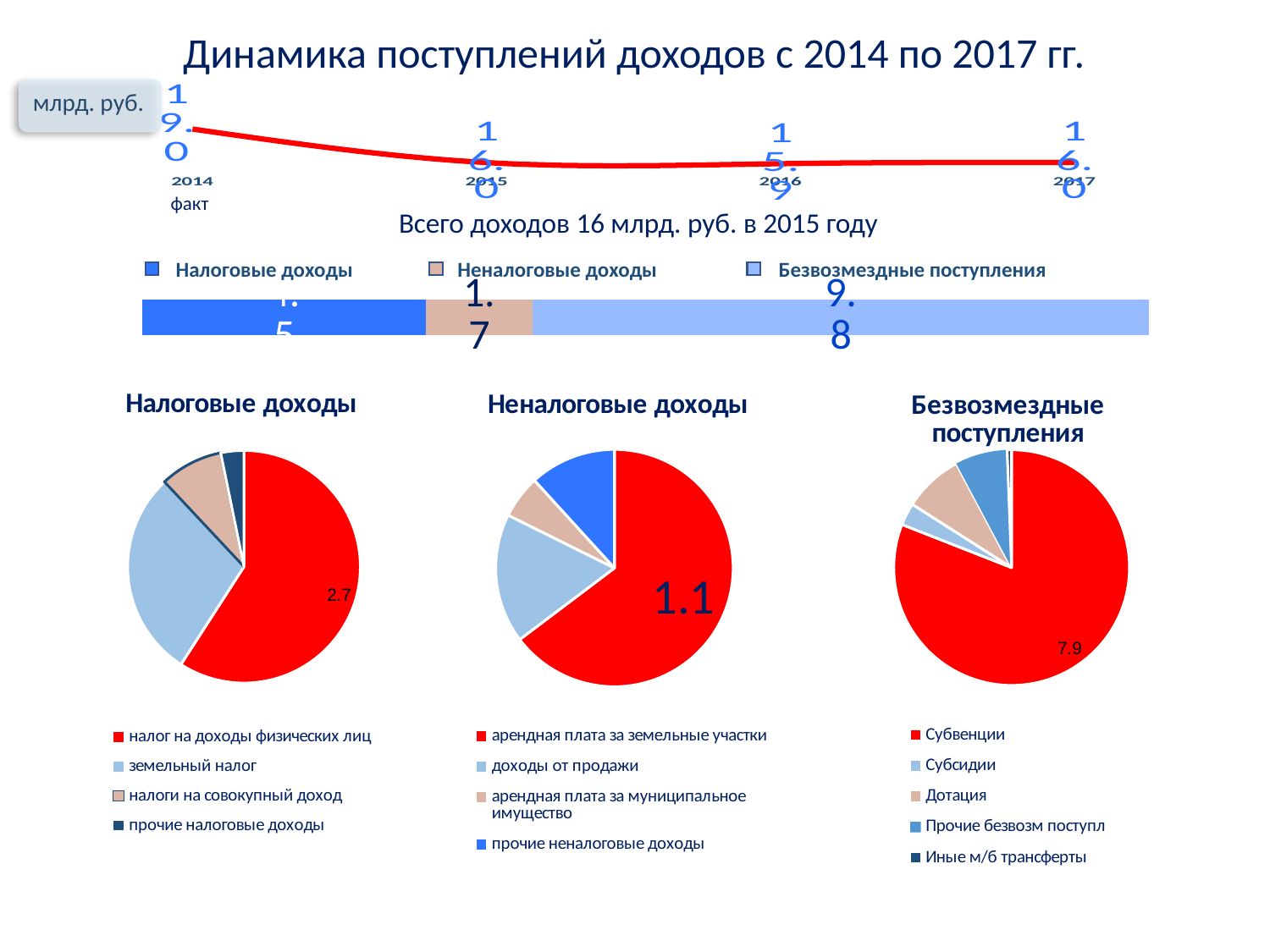
In the stacked bar chart, what is the difference between Безвозмездные поступления and Неналоговые доходы? 8.1 In the stacked bar chart for 2015, what is the value for Безвозмездные поступления? 9.8 In the top line chart, does the value rise or fall from 2014 to 2015? fall In the top line chart, what is the value for 2014? 19.0 What kind of chart is the top chart showing income from 2014 to 2017? line chart In the pie chart titled Безвозмездные поступления, what is the value for Субвенции? 7.9 In the top line chart, what is the value for 2016? 15.9 How many series does the legend of the stacked bar chart list? 3 In the top line chart, which year has the highest value? 2014 In the stacked bar chart for 2015, what is the value for Неналоговые доходы? 1.7 In the pie chart titled Неналоговые доходы, which category has the largest slice? арендная плата за земельные участки In the pie chart titled Налоговые доходы, what is the value for налог на доходы физических лиц? 2.7